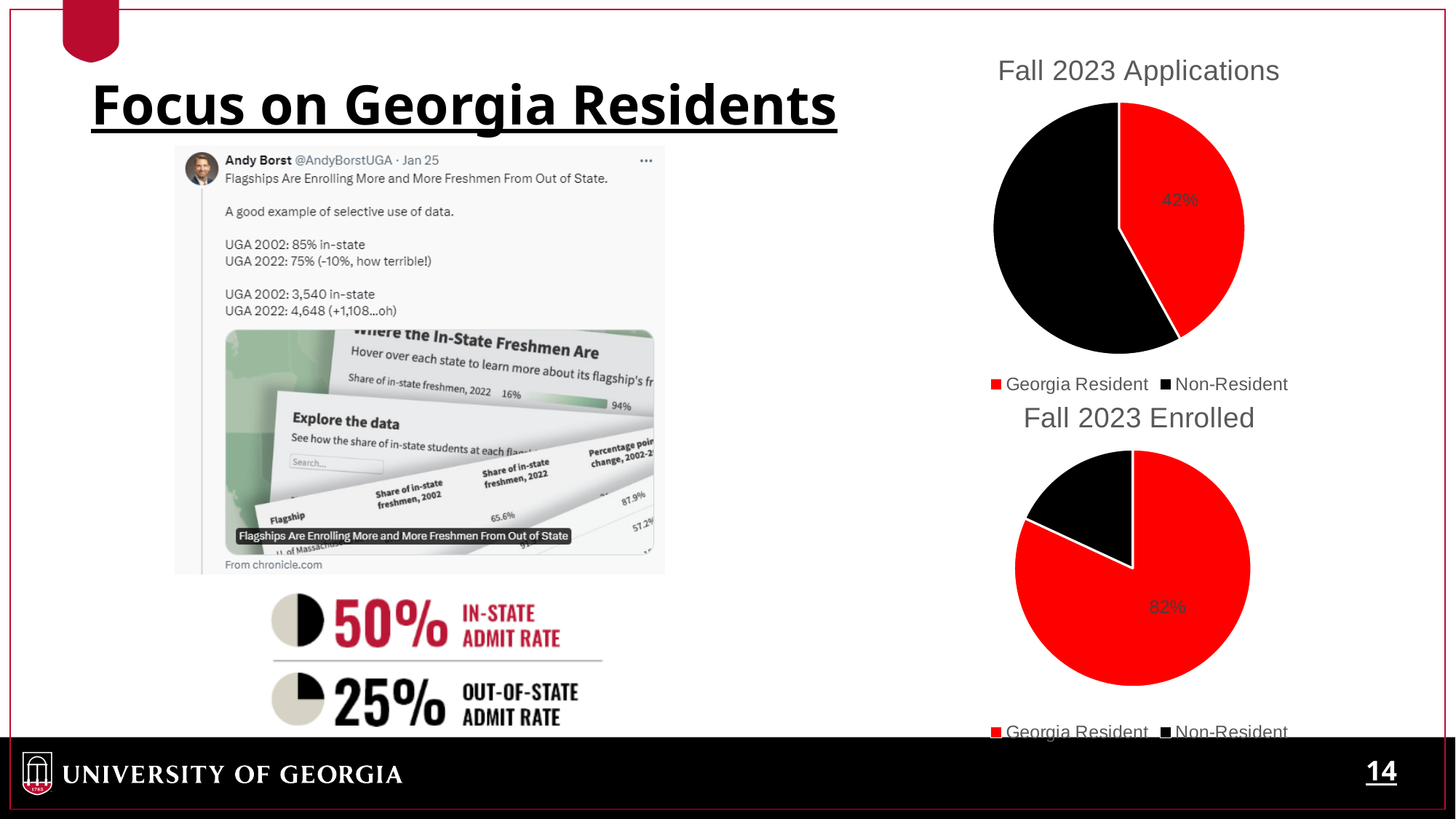
In the Fall 2023 Enrolled chart, what percentage is shown for Georgia Resident? 82% In the Fall 2023 Applications chart, what percentage is shown for Georgia Resident? 42% What kind of chart is the Fall 2023 Applications chart? Pie chart In the Fall 2023 Applications chart, which category has the larger slice? Non-Resident Is the Georgia Resident share larger in the Fall 2023 Applications chart or in the Fall 2023 Enrolled chart? Fall 2023 Enrolled In the Fall 2023 Applications chart, what colour represents Georgia Resident? Red What is the difference in percentage points between the Georgia Resident share in the Fall 2023 Enrolled chart and in the Fall 2023 Applications chart? 40 percentage points In the Fall 2023 Enrolled chart, which category has the larger slice? Georgia Resident In the Fall 2023 Enrolled chart, which category has the smaller slice? Non-Resident What kind of chart is the Fall 2023 Enrolled chart? Pie chart How many slices does the Fall 2023 Enrolled pie chart have? 2 How many categories does the legend of the Fall 2023 Applications chart list? 2